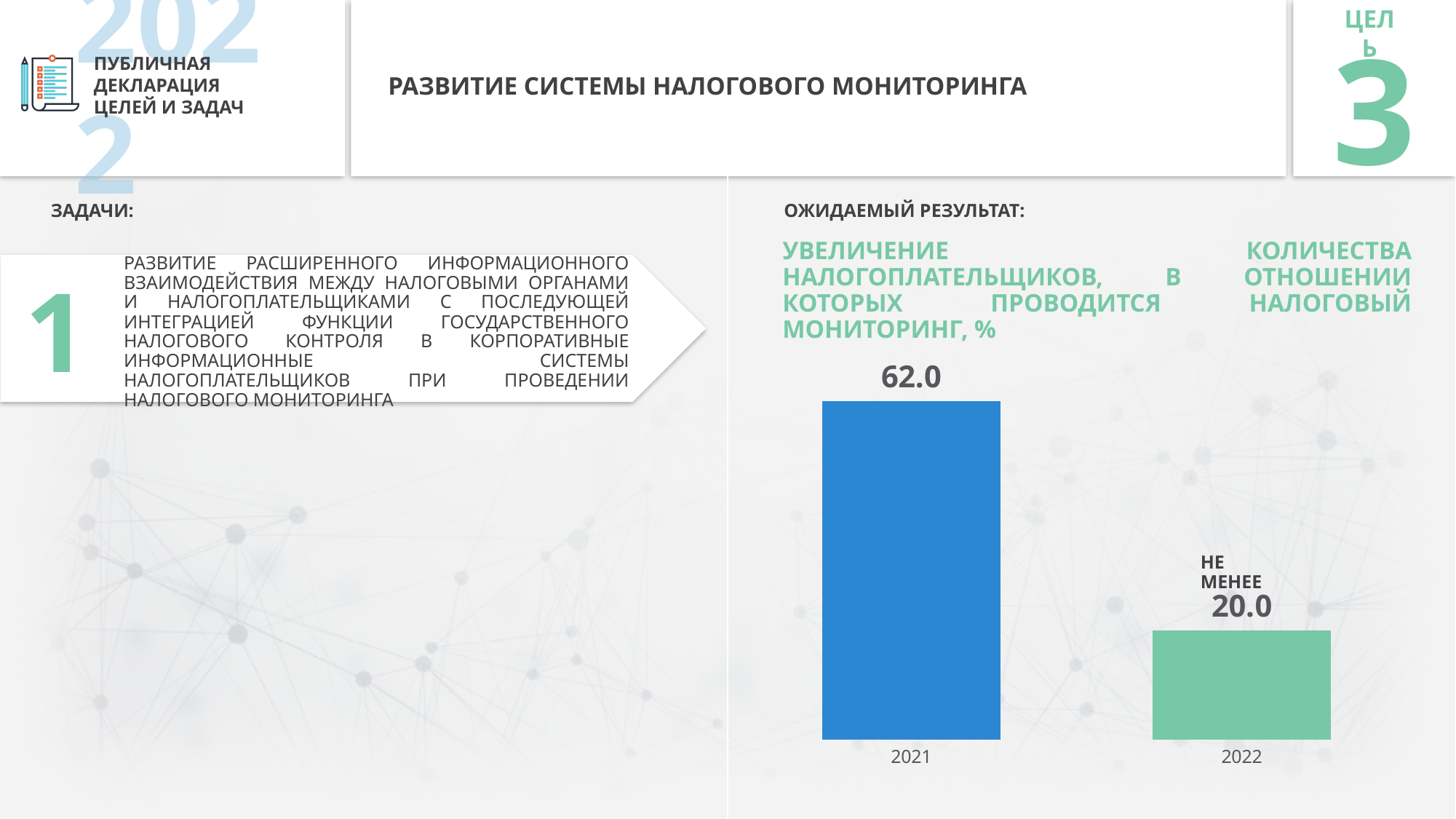
What is the value for 2021? 62.0 Do the values rise or fall from 2021 to 2022? fall What is the difference between the values for 2021 and 2022? 42.0 What is the value for 2022? 20.0 What colour is the bar for 2021? blue What kind of chart is shown on the slide? bar chart How many bars are shown in the chart? 2 Which year has the highest value? 2021 Which year has the lowest value? 2022 Which is larger, the value for 2021 or the value for 2022? 2021 What text is printed above the value label for 2022? НЕ МЕНЕЕ